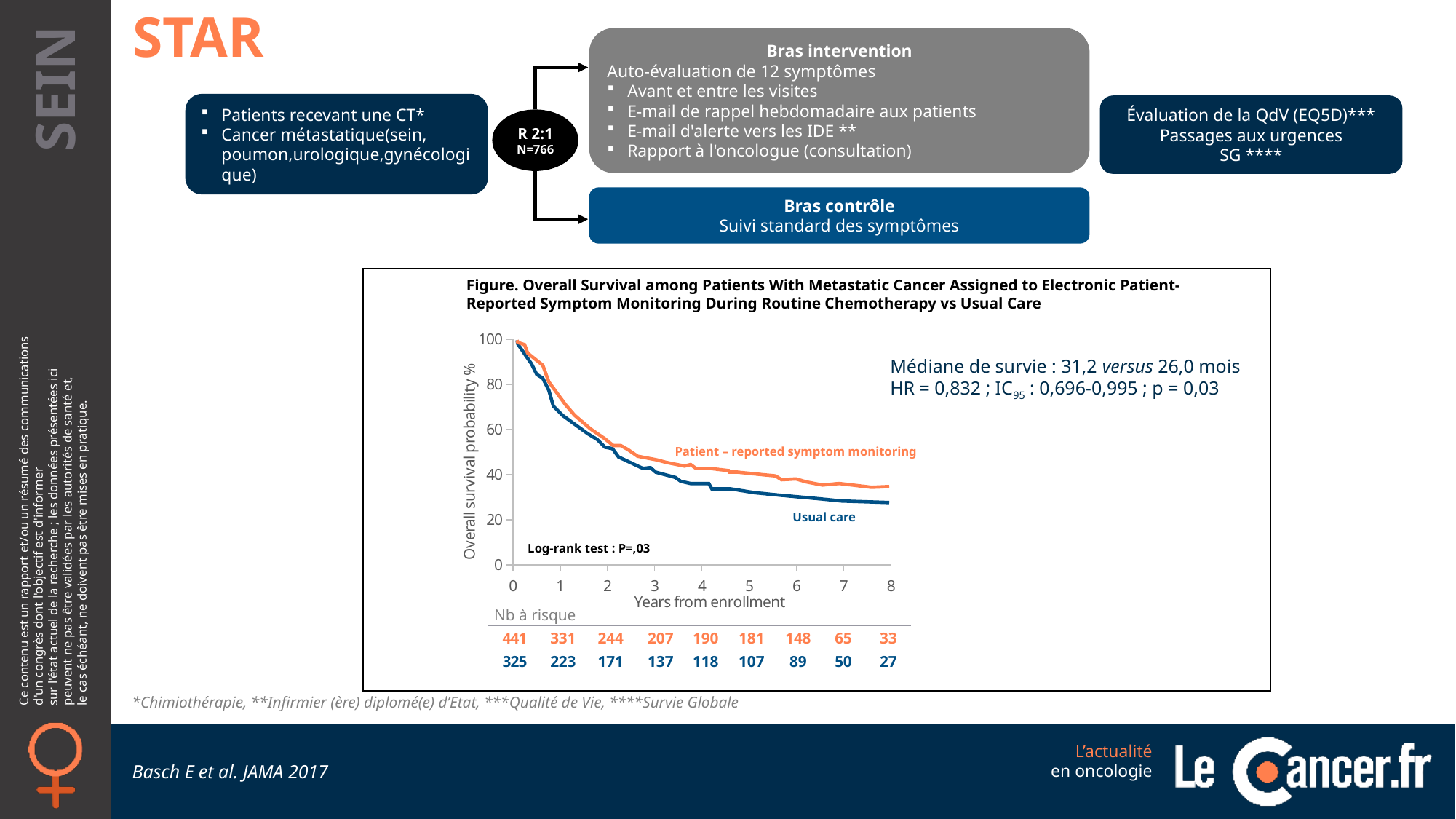
How many survival curves are plotted in the figure? 2 Is the overall survival probability for usual care at 8 years greater or less than 40? less What is the label of the x axis of the survival chart? Years from enrollment At year 8, what is the difference between the number at risk in the patient-reported symptom monitoring group and the usual care group? 6 How many patients in the usual care group were at risk at year 6? 89 In the number-at-risk table, how many patients were at risk at year 0 in the usual care group? 325 Do the survival curves rise or fall as years from enrollment increase? fall Which curve is higher at 8 years from enrollment, patient-reported symptom monitoring or usual care? Patient-reported symptom monitoring What kind of chart is shown in the figure on the slide? line chart In the number-at-risk table, how many patients were at risk at year 0 in the patient-reported symptom monitoring group? 441 How many patients in the patient-reported symptom monitoring group were at risk at year 4? 190 How many time points are listed in the number-at-risk table? 9